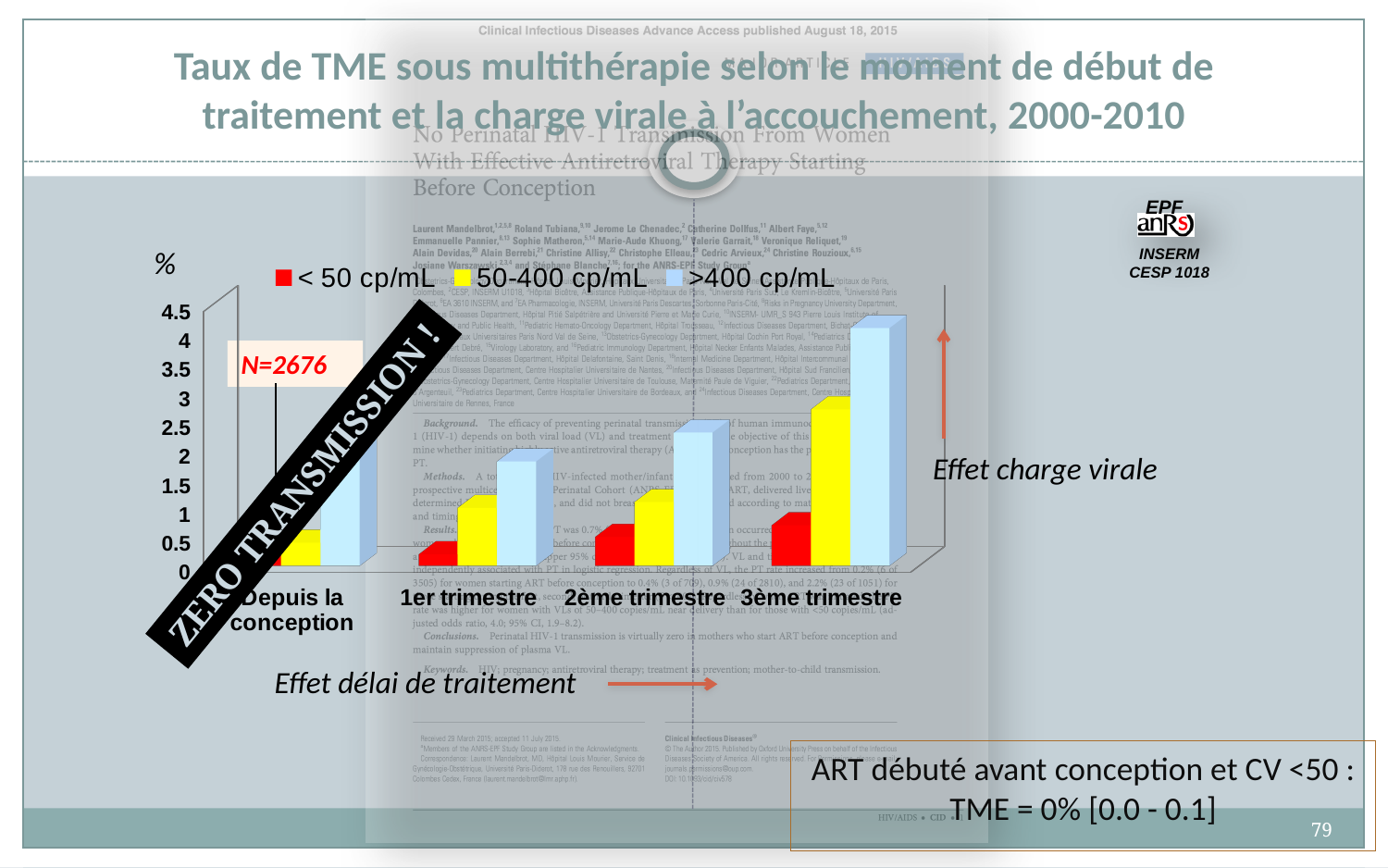
Which colour represents the <50 cp/mL series in the chart legend? red Is the value for >400 cp/mL in the 3ème trimestre category greater or less than 3? greater What sample size (N) is annotated on the chart? N=2676 What kind of chart is shown on the slide? bar chart How many treatment-start categories are shown on the x axis of the chart? 4 How many series does the chart legend list? 3 Is the value for 50-400 cp/mL in the 1er trimestre category greater or less than 2? less Is the value for >400 cp/mL in the 1er trimestre category greater or less than 1? greater According to the slide, what is the TME rate for ART started before conception with viral load <50? 0% Do the values for the >400 cp/mL series rise or fall from 'Depuis la conception' to '3ème trimestre'? rise In the 3ème trimestre category, which is larger: the <50 cp/mL bar or the >400 cp/mL bar? >400 cp/mL Which category has the tallest bar for the >400 cp/mL series? 3ème trimestre